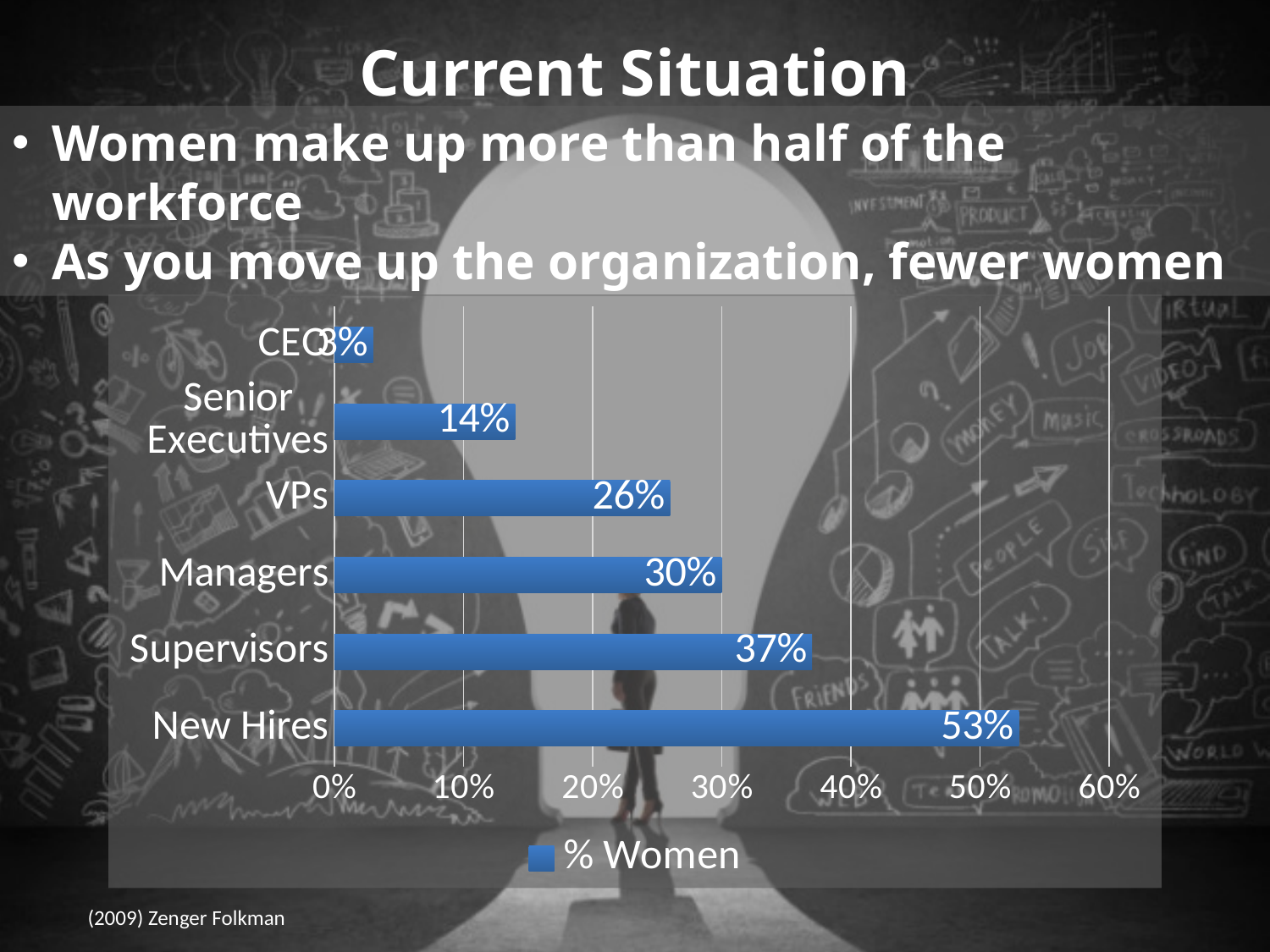
What is the difference between the values for New Hires and Managers? 23% Is the value for Supervisors greater or less than 40%? less What type of chart is shown on the slide? Bar chart What percentage is shown for Senior Executives? 14% What percentage of New Hires are women according to the chart? 53% Which is larger, the value for Managers or the value for VPs? Managers What series name is shown in the chart legend? % Women Which category has the highest percentage of women? New Hires Which category has the lowest percentage of women? CEO How many categories are shown in the chart? 6 What is the value for VPs in the chart? 26% What is the value shown for Supervisors in the chart? 37%